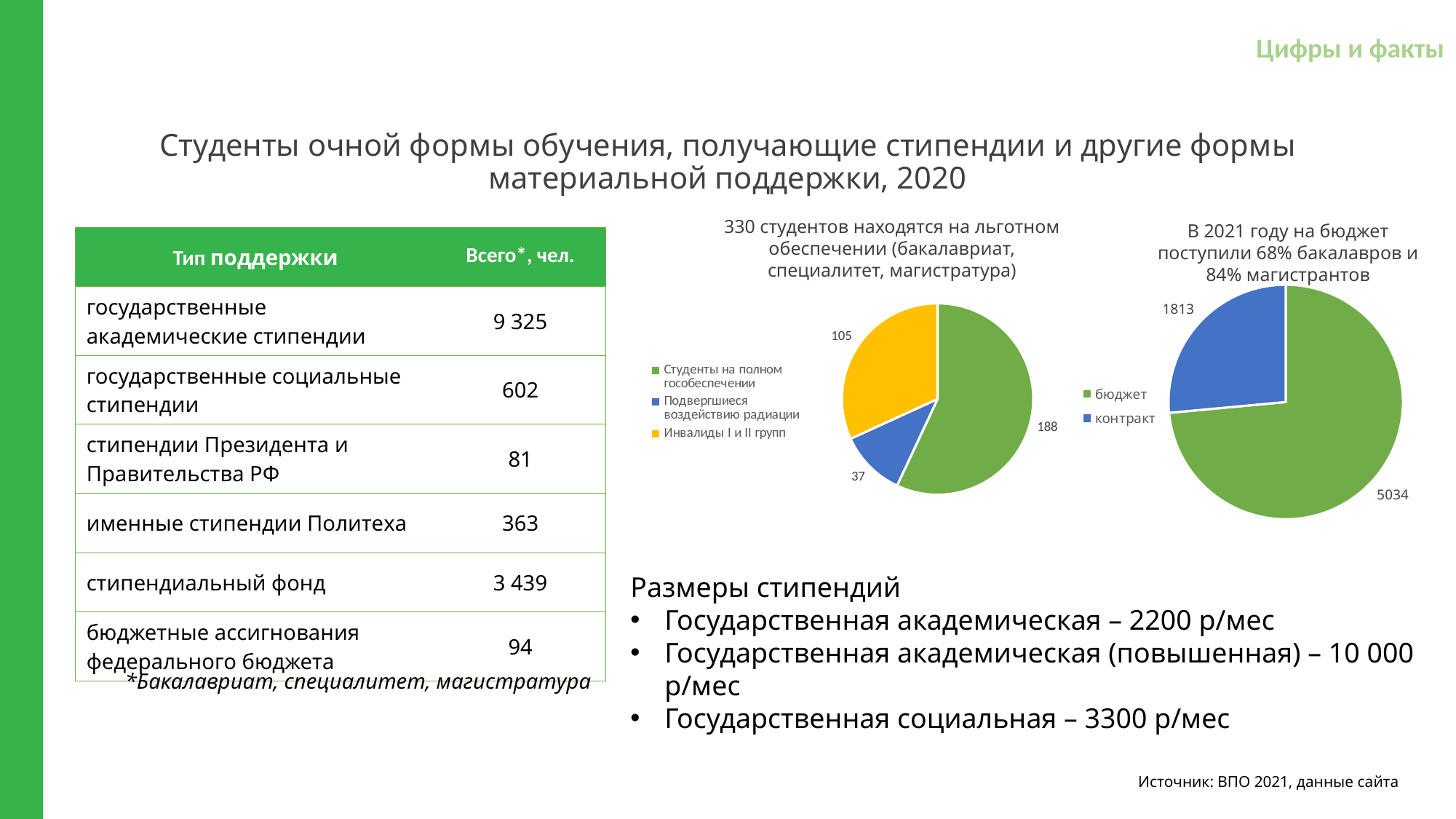
In the right pie chart (В 2021 году на бюджет поступили...), what is the value for контракт? 1813 In the left pie chart (330 студентов находятся на льготном обеспечении), what is the difference between Студенты на полном гособеспечении and Инвалиды I и II групп? 83 In the right pie chart (В 2021 году на бюджет поступили...), which is larger, бюджет or контракт? бюджет In the right pie chart (В 2021 году на бюджет поступили...), what is the difference between бюджет and контракт? 3221 In the left pie chart (330 студентов находятся на льготном обеспечении), which category has the smallest slice? Подвергшиеся воздействию радиации In the left pie chart (330 студентов находятся на льготном обеспечении), what is the value for Студенты на полном гособеспечении? 188 In the left pie chart (330 студентов находятся на льготном обеспечении), what is the value for Подвергшиеся воздействию радиации? 37 In the left pie chart (330 студентов находятся на льготном обеспечении), how many categories does the legend list? 3 In the left pie chart (330 студентов находятся на льготном обеспечении), what is the value for Инвалиды I и II групп? 105 What type of chart is the right chart (В 2021 году на бюджет поступили...)? pie chart In the right pie chart (В 2021 году на бюджет поступили...), what is the value for бюджет? 5034 In the left pie chart (330 студентов находятся на льготном обеспечении), which category has the largest slice? Студенты на полном гособеспечении